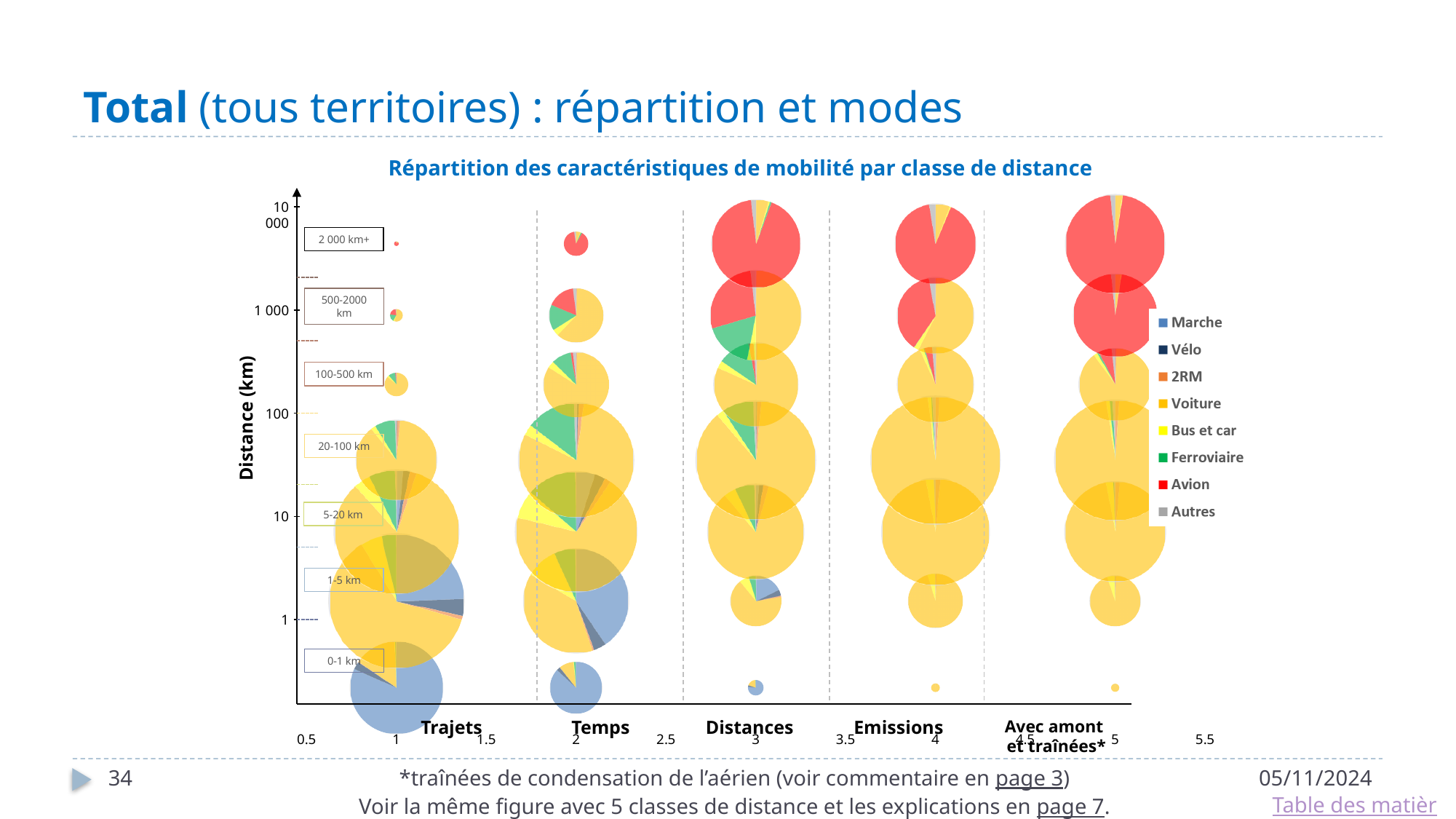
What is the title of the chart? Répartition des caractéristiques de mobilité par classe de distance In the Emissions column, which mode takes the largest share of the 5-20 km bubble? Voiture In the Emissions column, which bubble is larger: the 0-1 km bubble or the 2 000 km+ bubble? 2 000 km+ In the Trajets column, which bubble is larger: the 0-1 km bubble or the 2 000 km+ bubble? 0-1 km How many modes does the legend list? 8 In the Trajets column, which mode takes the largest share of the 0-1 km bubble? Marche How many distance classes are labelled along the y axis? 7 In the Distances column, which mode takes the largest share of the 2 000 km+ bubble? Avion What kind of chart is shown on the slide? bubble chart In the Trajets column, do the bubble sizes rise or fall as the distance class increases from 5-20 km to 2 000 km+? fall What is the label of the y axis? Distance (km) How many characteristic columns (Trajets, Temps, etc.) are shown along the x axis? 5